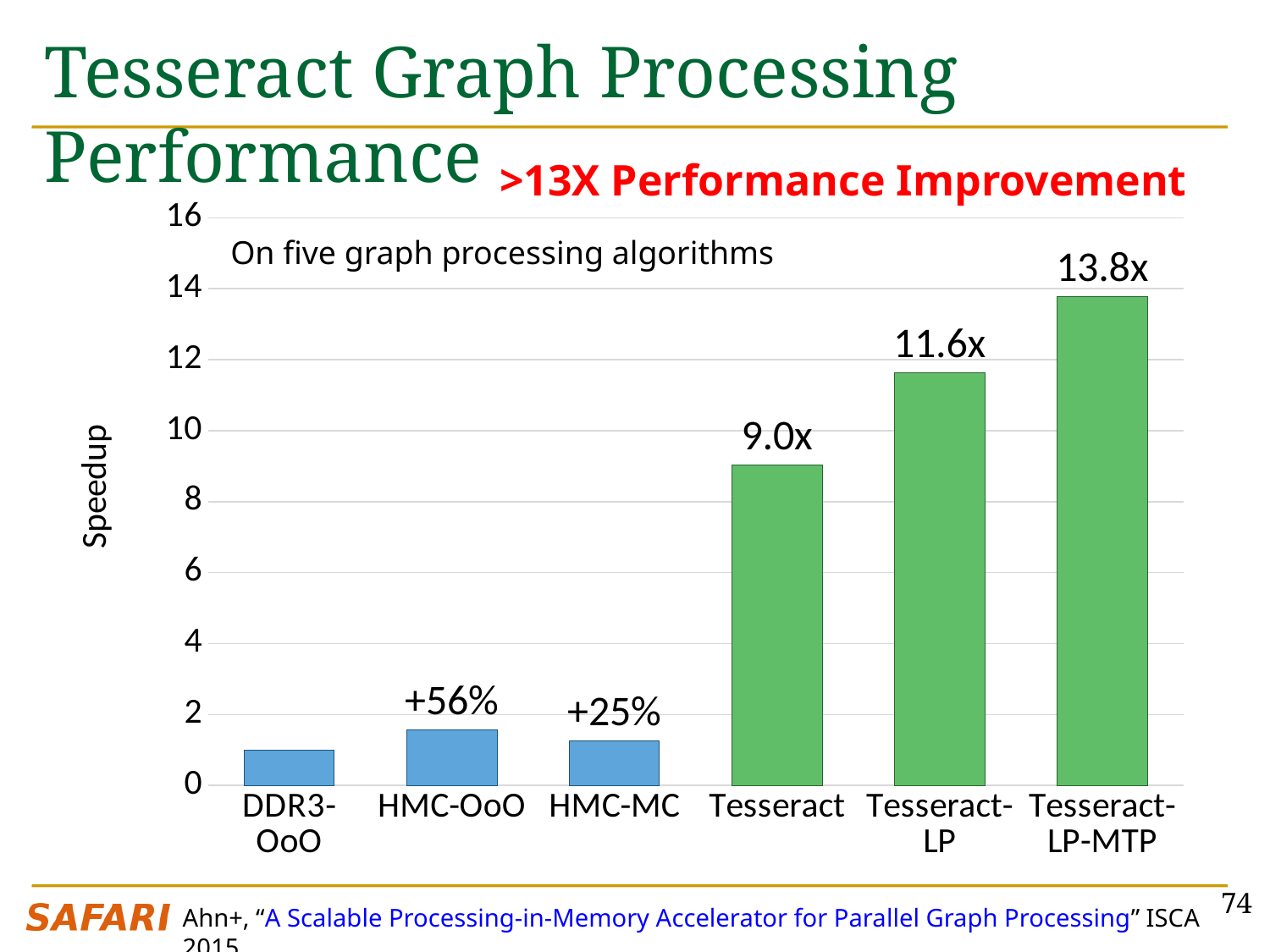
What is the label on the y axis? Speedup What is the speedup shown for Tesseract-LP-MTP? 13.8x What label is printed above the HMC-OoO bar? +56% Which configuration has the lowest speedup? DDR3-OoO Which configuration has the highest speedup? Tesseract-LP-MTP How many configurations are shown on the x axis? 6 Which has a larger speedup, Tesseract-LP or Tesseract? Tesseract-LP What is the difference in speedup between Tesseract-LP-MTP and Tesseract? 4.8x What label is printed above the HMC-MC bar? +25% What is the speedup shown for Tesseract? 9.0x Is the speedup for DDR3-OoO greater or less than 2? less What is the speedup shown for Tesseract-LP? 11.6x